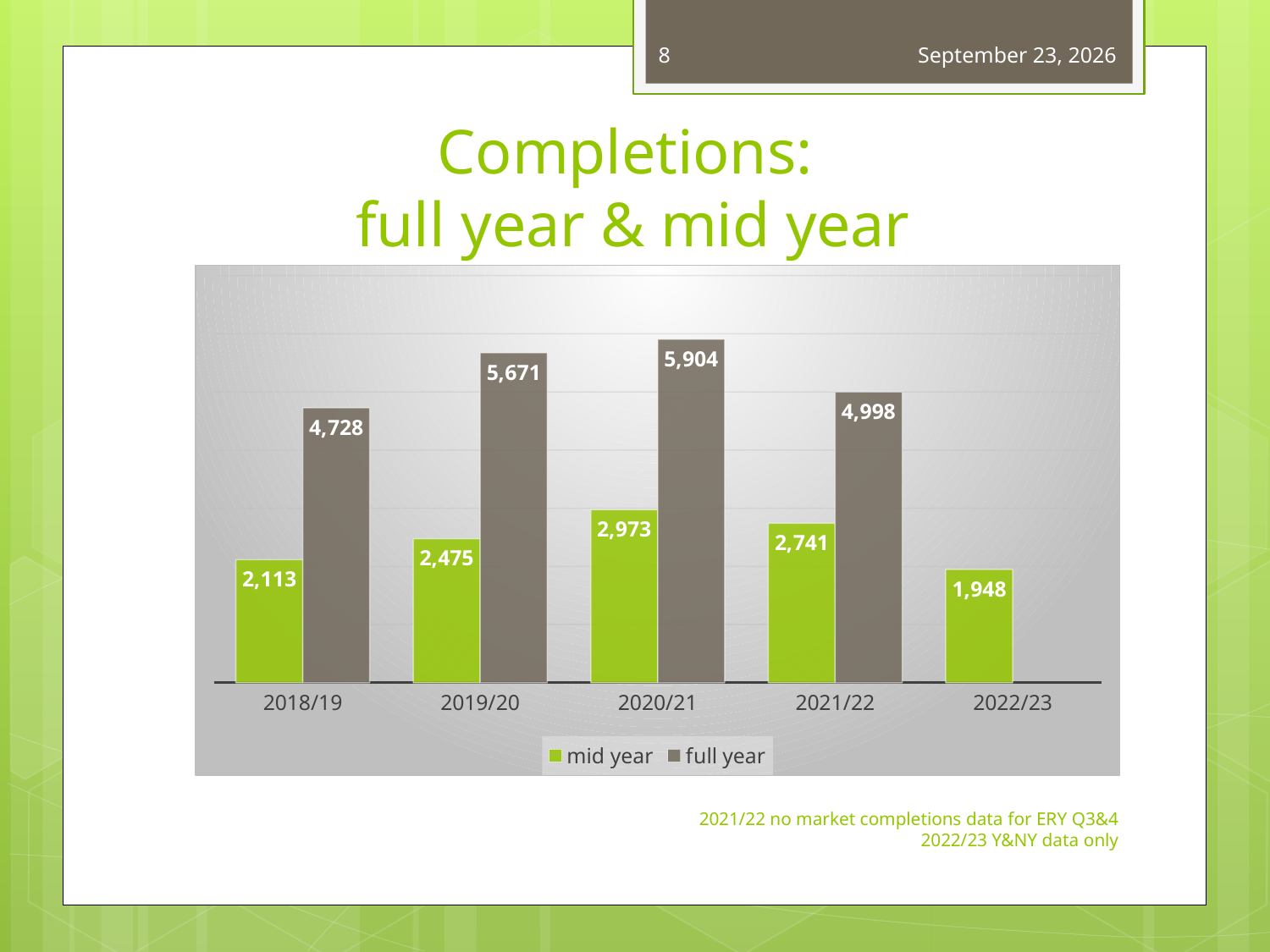
Which year has the lowest mid year value? 2022/23 What is the mid year value for 2018/19? 2,113 What is the full year value for 2021/22? 4,998 What is the difference between the full year and mid year values for 2019/20? 3,196 What kind of chart is shown on the slide? bar chart Which is larger, the mid year value for 2020/21 or the mid year value for 2021/22? 2020/21 Which year has the highest full year value? 2020/21 What is the full year value for 2020/21? 5,904 Which series is shown in green? mid year How many series does the legend list? 2 How many years are shown on the x axis? 5 What is the mid year value for 2022/23? 1,948